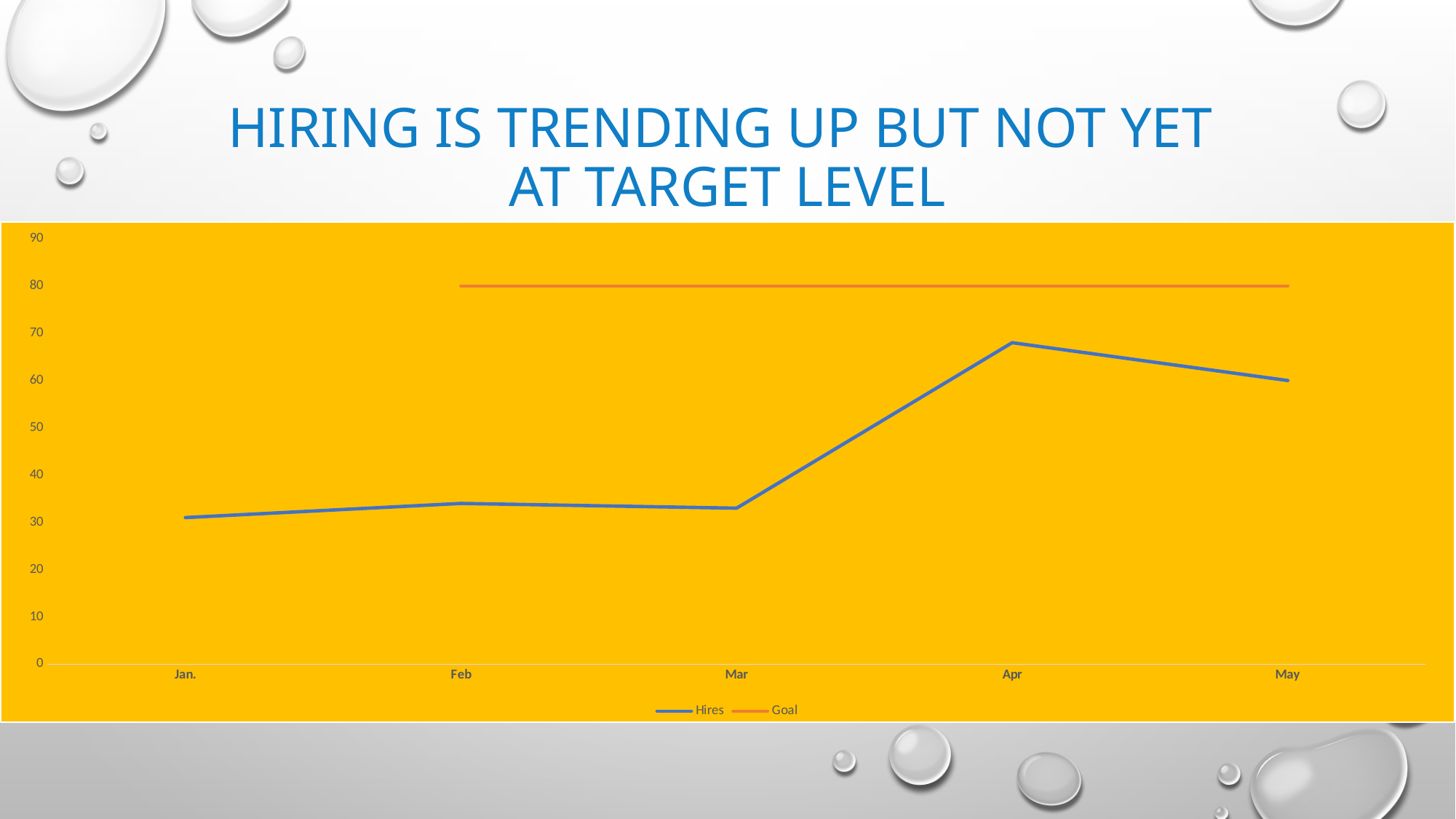
What is the value of the Goal series? 80 How many series does the legend list? 2 In which month is the Hires value highest? Apr Is the Hires value for Apr greater or less than 60? greater Which is larger, the Hires value for Apr or for May? Apr Is the Hires value for May greater or less than 50? greater Is the Hires value for Jan. greater or less than 40? less What is the title of the slide? HIRING IS TRENDING UP BUT NOT YET AT TARGET LEVEL What are the two series named in the legend? Hires and Goal How many months are shown on the x axis? 5 What kind of chart is shown on the slide? line chart Do the Hires values rise or fall from Mar to Apr? rise